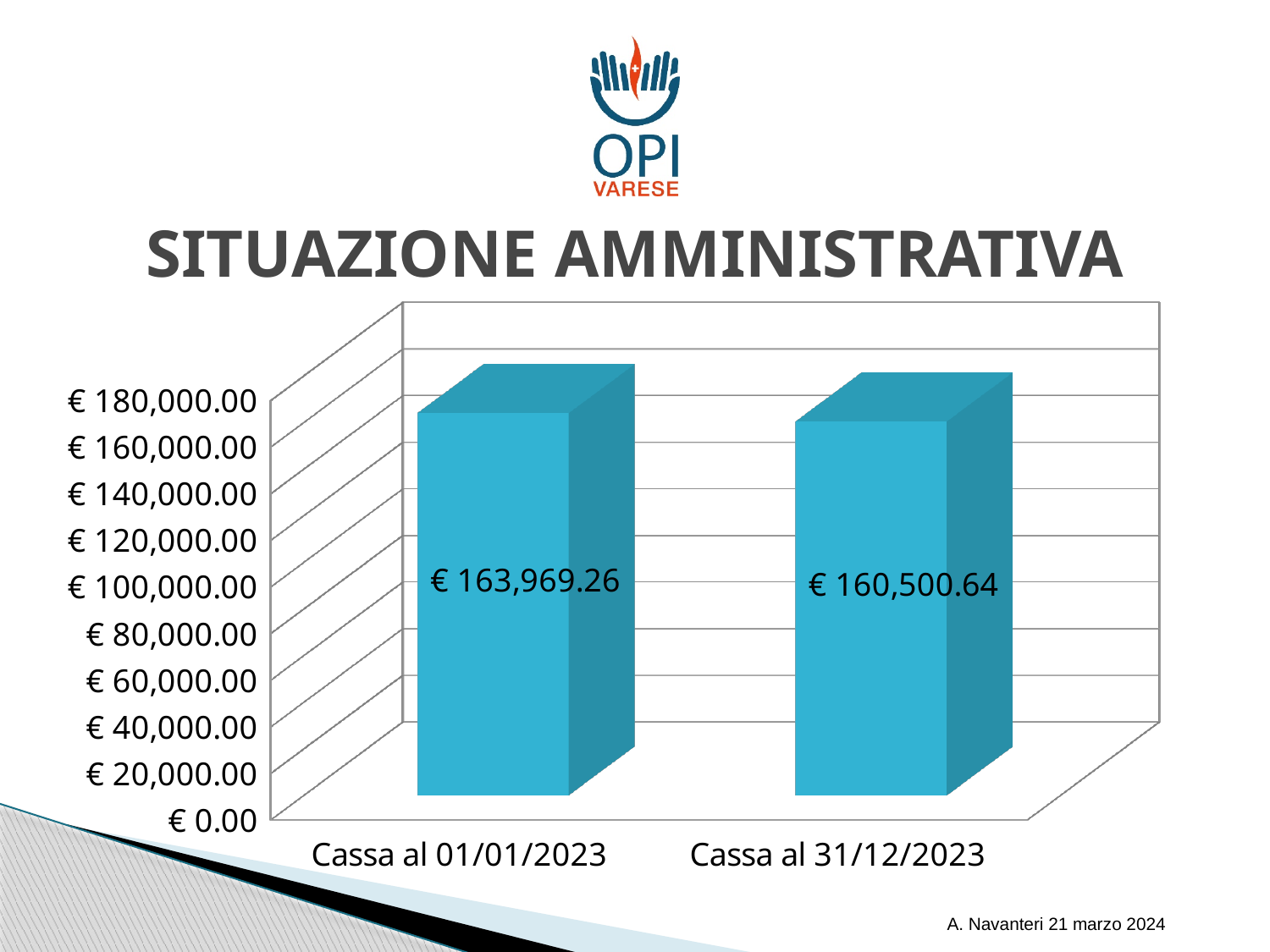
What is the title shown above the chart? SITUAZIONE AMMINISTRATIVA Is the value for Cassa al 01/01/2023 greater or less than € 180,000.00? less What kind of chart is shown on the slide? bar chart What is the value for Cassa al 31/12/2023? € 160,500.64 What is the value for Cassa al 01/01/2023? € 163,969.26 What is the difference between the value for Cassa al 01/01/2023 and the value for Cassa al 31/12/2023? € 3,468.62 Which category has the highest value? Cassa al 01/01/2023 How many categories are shown in the chart? 2 Do the values rise or fall from Cassa al 01/01/2023 to Cassa al 31/12/2023? fall Which category has the lowest value? Cassa al 31/12/2023 Is the value for Cassa al 31/12/2023 greater or less than € 140,000.00? greater Which is larger, the value for Cassa al 01/01/2023 or the value for Cassa al 31/12/2023? Cassa al 01/01/2023